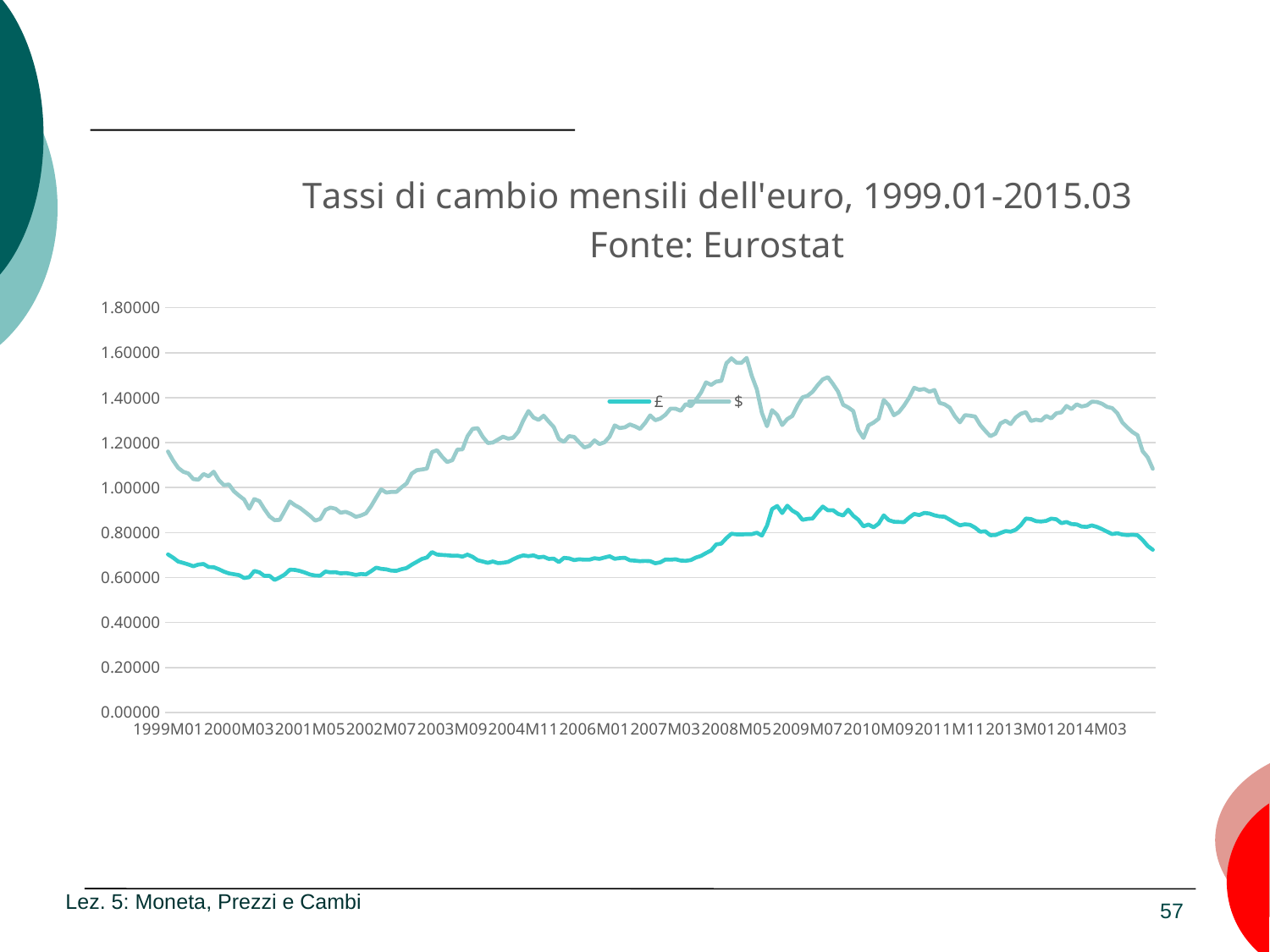
Is the value of the £ series at 1999M01 greater or less than 0.60000? greater What are the two series named in the legend? £ and $ Does the $ series rise or fall between 1999M01 and 2000M03? fall Is the highest value reached by the $ series greater or less than 1.40000? greater Which series, £ or $, has the higher values across the whole period? $ Is the value of the £ series at the end of the period (2015) greater or less than 0.80000? less What kind of chart is shown on the slide? line chart What is the source cited in the chart title? Eurostat Does the £ series rise or fall between 2007M03 and 2009M07? rise How many series does the legend list? 2